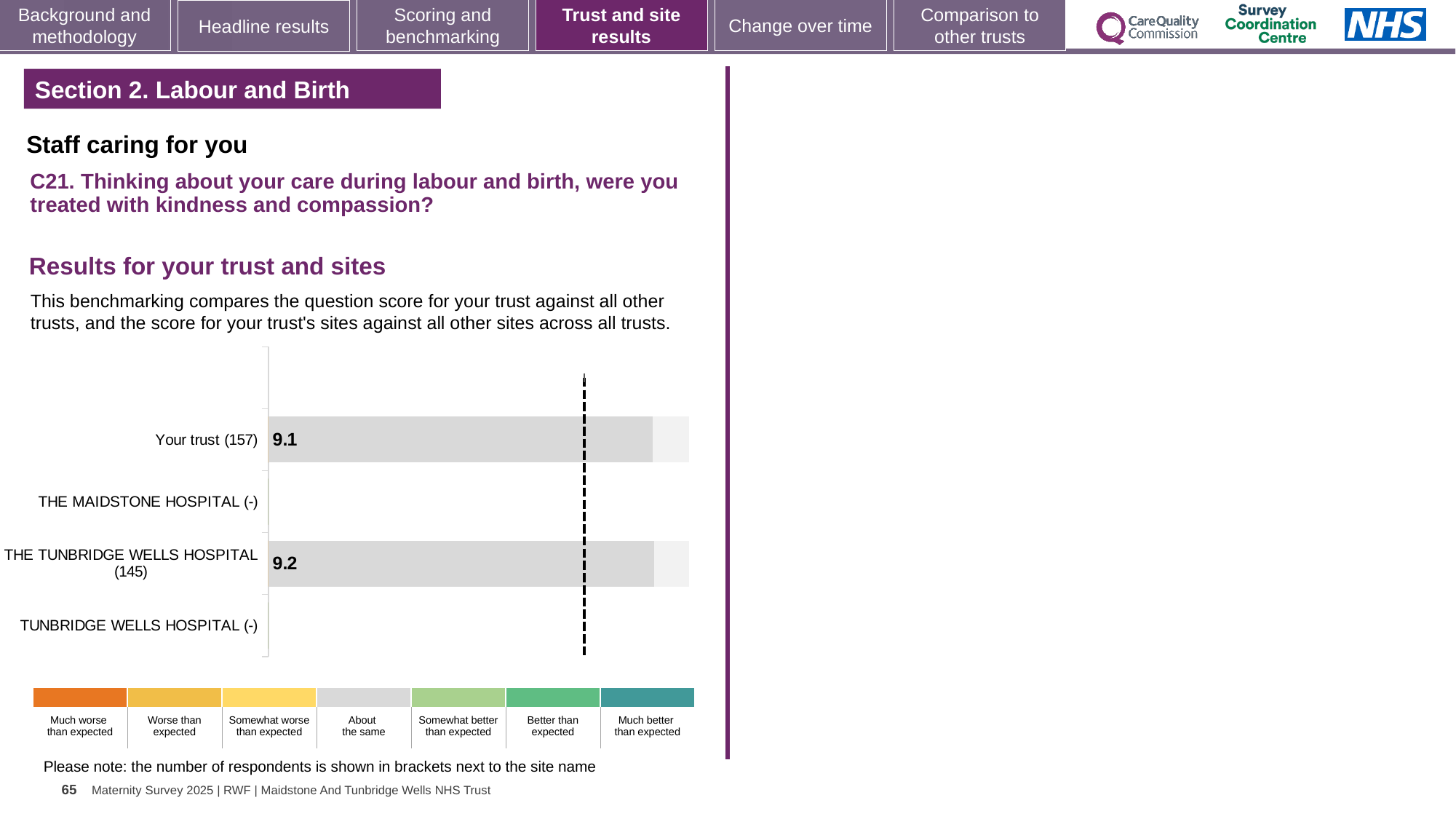
How many categories are listed on the chart's vertical axis? 4 What kind of chart is shown on the slide? Bar chart How many rating bands are shown in the colour key below the chart? 7 How many respondents are shown in brackets for THE TUNBRIDGE WELLS HOSPITAL? 145 What is the score for Your trust (157)? 9.1 What is the score for THE TUNBRIDGE WELLS HOSPITAL (145)? 9.2 Which categories on the chart have no bar plotted? THE MAIDSTONE HOSPITAL (-) and TUNBRIDGE WELLS HOSPITAL (-) What is the difference between the score for THE TUNBRIDGE WELLS HOSPITAL (145) and the score for Your trust (157)? 0.1 Which has the higher score, Your trust (157) or THE TUNBRIDGE WELLS HOSPITAL (145)? THE TUNBRIDGE WELLS HOSPITAL (145) How many respondents are shown in brackets for Your trust? 157 Which category has the highest plotted score on the chart? THE TUNBRIDGE WELLS HOSPITAL (145)